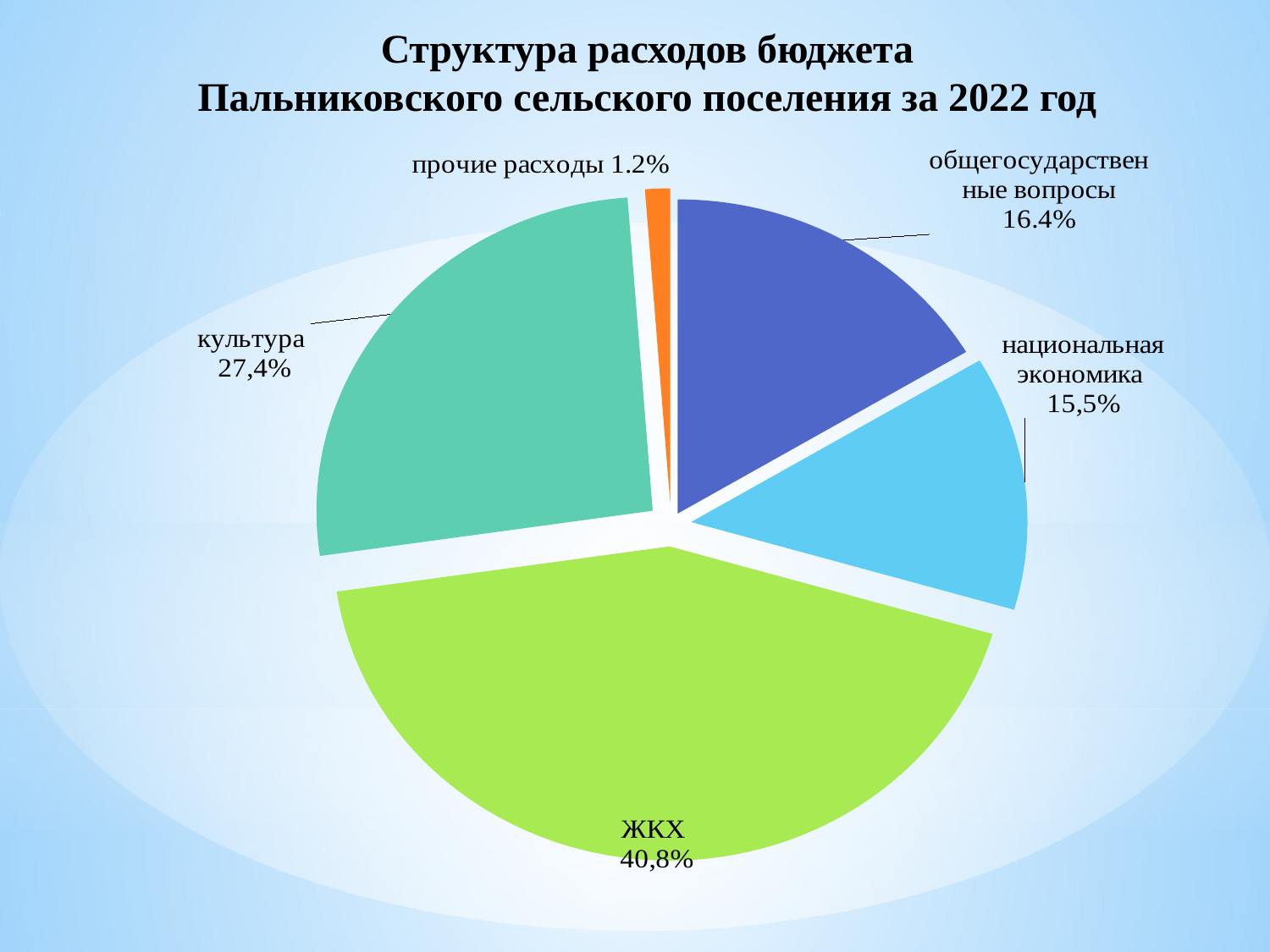
What share of budget expenditure is прочие расходы? 1.2% What share of budget expenditure is общегосударственные вопросы? 16.4% How many expenditure categories are shown in the pie chart? 5 What is the title of the chart? Структура расходов бюджета Пальниковского сельского поселения за 2022 год Which expenditure category has the largest share of the budget? ЖКХ What kind of chart is shown on the slide? pie chart What share of budget expenditure is ЖКХ? 40,8% What share of budget expenditure is культура? 27,4% Which is larger, the share for культура or the share for национальная экономика? культура Which expenditure category has the smallest share of the budget? прочие расходы What share of budget expenditure is национальная экономика? 15,5% What is the difference between the share for ЖКХ and the share for культура? 13,4%